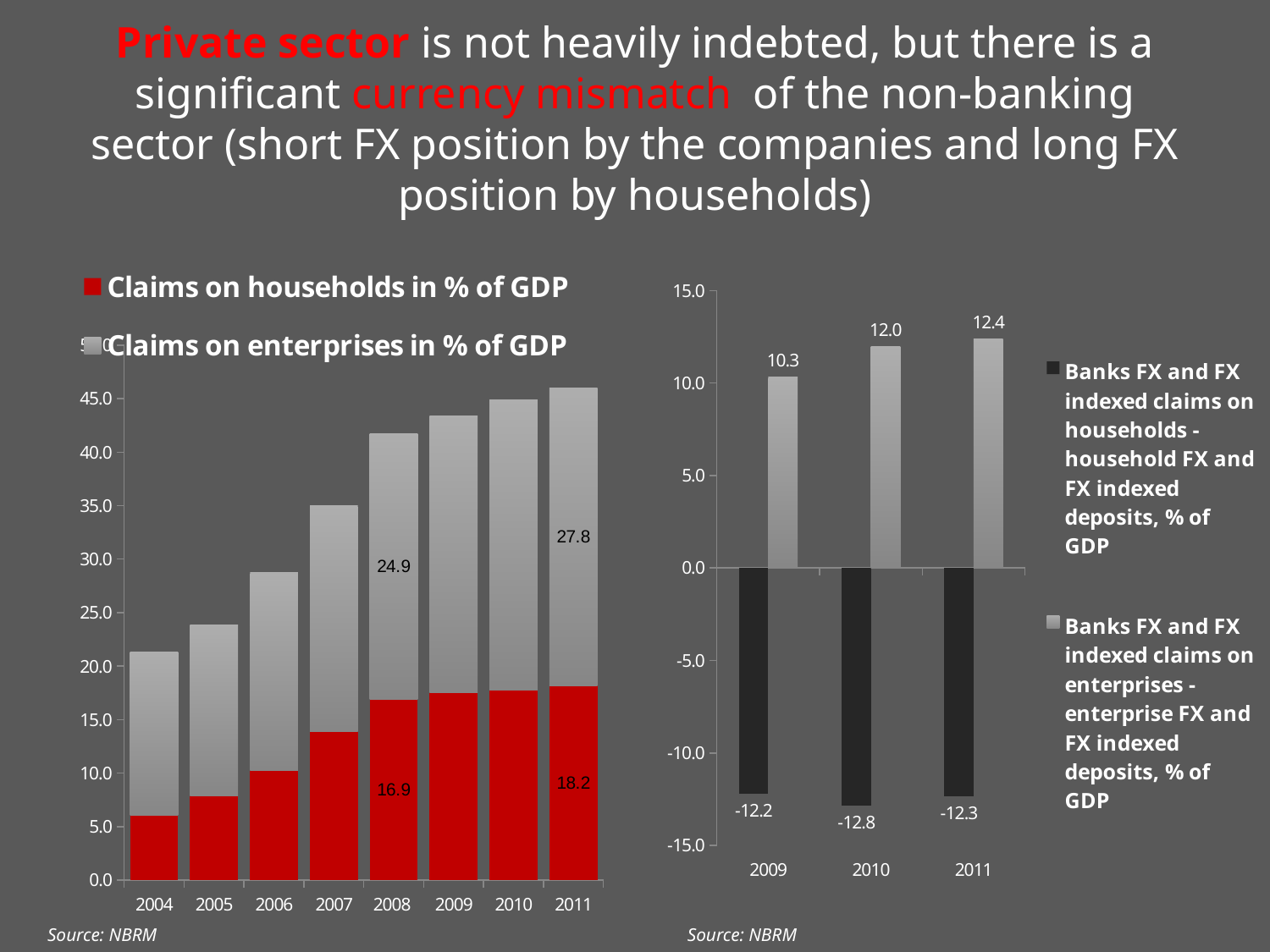
In the right chart, what is the value for Banks FX and FX indexed claims on enterprises minus enterprise FX deposits in 2010? 12.0 In the right chart, what is the value for Banks FX and FX indexed claims on households minus household FX deposits in 2011? -12.3 In the left chart, what is the value of Claims on households in % of GDP for 2008? 16.9 What kind of chart is the left chart? Stacked bar chart In the left chart, do the total claims rise or fall from 2004 to 2011? Rise In the left chart, what is the value of Claims on enterprises in % of GDP for 2011? 27.8 In the left chart, which is larger in 2011: Claims on households or Claims on enterprises? Claims on enterprises In the left chart, how many years are shown on the x axis? 8 In the left chart, is the total value for 2004 greater or less than 25.0? less In the right chart, what is the difference between the enterprises values for 2011 and 2009? 2.1 In the right chart, in which year is the enterprises series highest? 2011 In the left chart, what is the total height of the stacked bar for 2011? 46.0